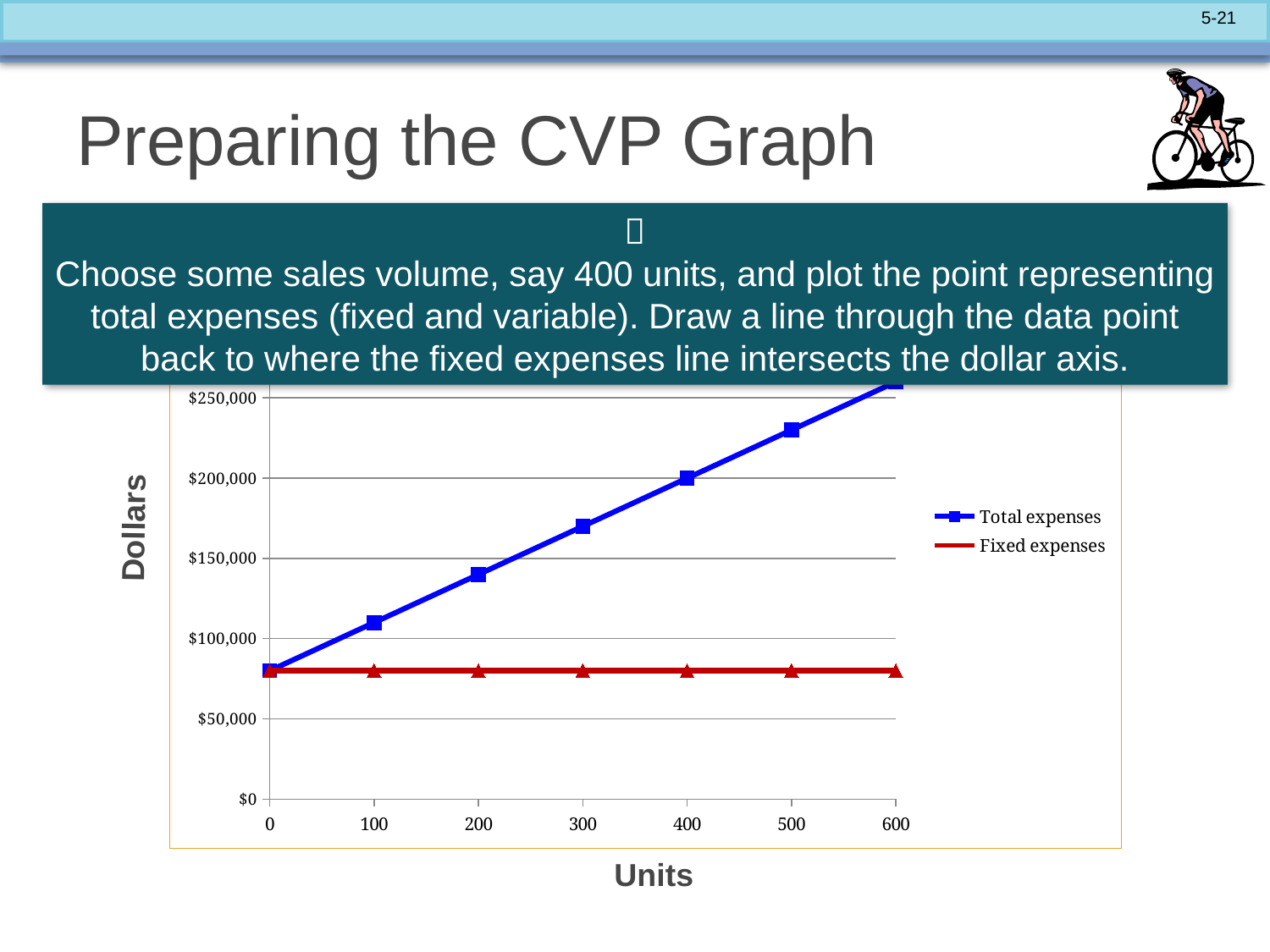
What is the title of the vertical axis of the chart? Dollars Is the value of Fixed expenses at 300 units greater or less than $100,000? less Do Total expenses rise or fall as units increase along the x axis? rise Is the value of Total expenses at 200 units greater or less than $150,000? less What is the value of Total expenses at 400 units? $200,000 What kind of chart is shown on the slide? line chart At 400 units, which series has the larger value, Total expenses or Fixed expenses? Total expenses What are the two series named in the chart legend? Total expenses and Fixed expenses Is the value of Fixed expenses at 100 units greater or less than $50,000? greater How many series does the chart legend list? 2 Do Fixed expenses rise, fall, or stay flat as units increase along the x axis? stay flat